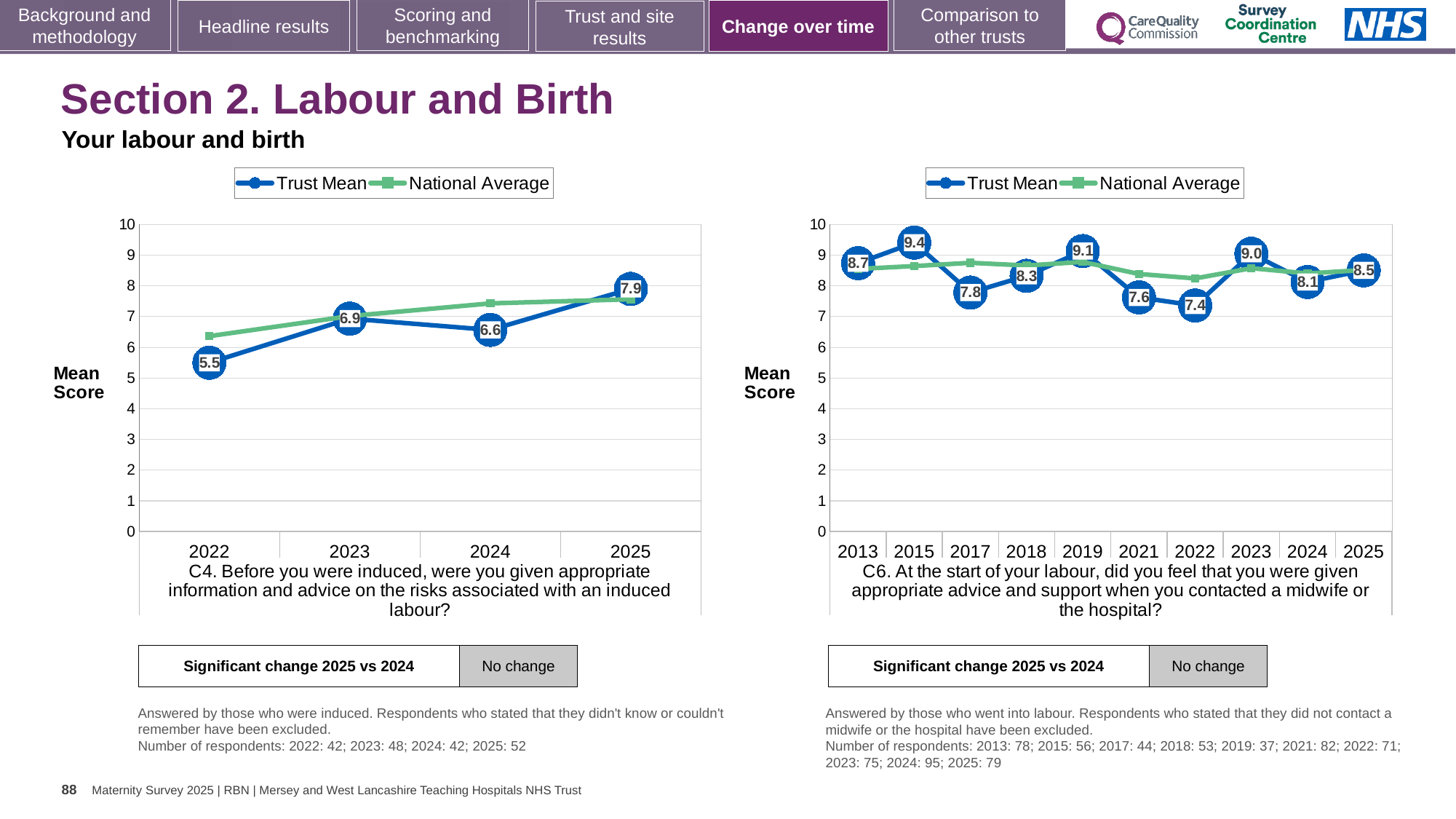
In the right chart (C6), what is the Trust Mean for 2022? 7.4 In the left chart (C4), how many series does the legend list? 2 In the left chart (C4), what is the difference between the Trust Mean for 2025 and 2024? 1.3 In the right chart (C6), which year has the highest Trust Mean? 2015 In the right chart (C6), how many years are plotted on the x axis? 10 In the left chart (C4), is the National Average for 2022 greater or less than 6? greater In the left chart (C4), what is the Trust Mean for 2025? 7.9 In the left chart (C4), which year has the lowest Trust Mean? 2022 In the right chart (C6), what is the Trust Mean for 2015? 9.4 In the right chart (C6), which is larger, the Trust Mean for 2019 or for 2021? 2019 In the left chart (C4), what is the Trust Mean for 2022? 5.5 What kind of chart is the right chart (C6)? Line chart